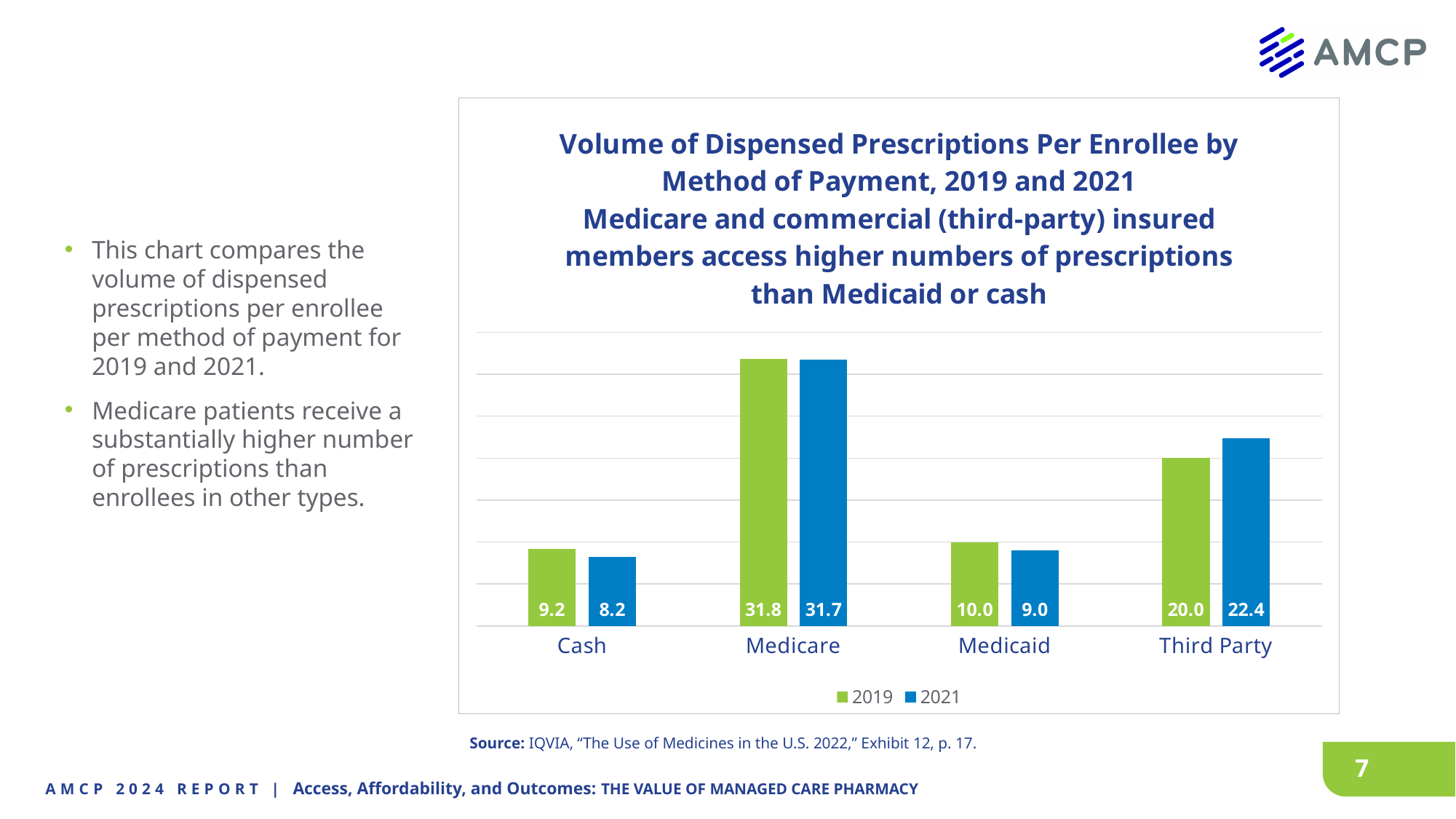
How many series does the legend list? 2 What is the value for Cash in 2021? 8.2 Which method of payment has the highest value in 2021? Medicare What is the volume of dispensed prescriptions per enrollee for Medicare in 2019? 31.8 Which method of payment has the lowest value in 2019? Cash Which colour represents the 2021 series in the chart? Blue What is the value for Third Party in 2021? 22.4 Which is larger for Medicaid: the 2019 value or the 2021 value? 2019 What is the difference between the 2019 values for Medicaid and Cash? 0.8 How many methods of payment are shown on the x axis? 4 What is the difference between the 2021 and 2019 values for Third Party? 2.4 What kind of chart is shown on the slide? Bar chart